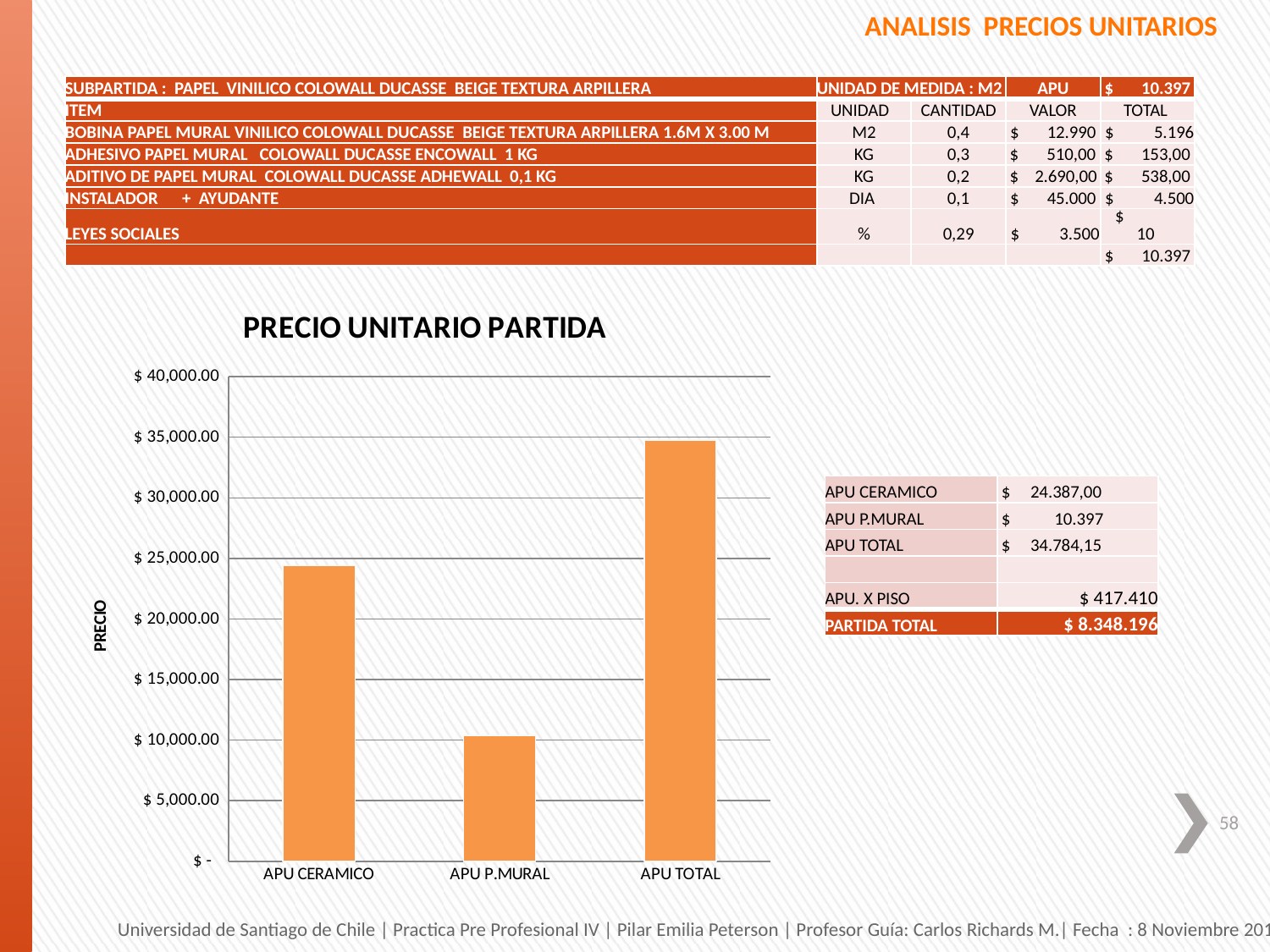
What is the label of the vertical axis of the chart? PRECIO How many categories are plotted in the PRECIO UNITARIO PARTIDA chart? 3 Which is larger, the bar for APU TOTAL or the bar for APU CERAMICO? APU TOTAL Is the value for APU CERAMICO greater or less than $ 25,000.00? less Is the value for APU TOTAL greater or less than $ 30,000.00? greater Which is larger, the bar for APU CERAMICO or the bar for APU P.MURAL? APU CERAMICO Is the value for APU P.MURAL greater or less than $ 15,000.00? less Which category has the lowest bar in the PRECIO UNITARIO PARTIDA chart? APU P.MURAL What is the title of the chart on the slide? PRECIO UNITARIO PARTIDA Which category has the highest bar in the PRECIO UNITARIO PARTIDA chart? APU TOTAL What kind of chart is shown on the slide? bar chart